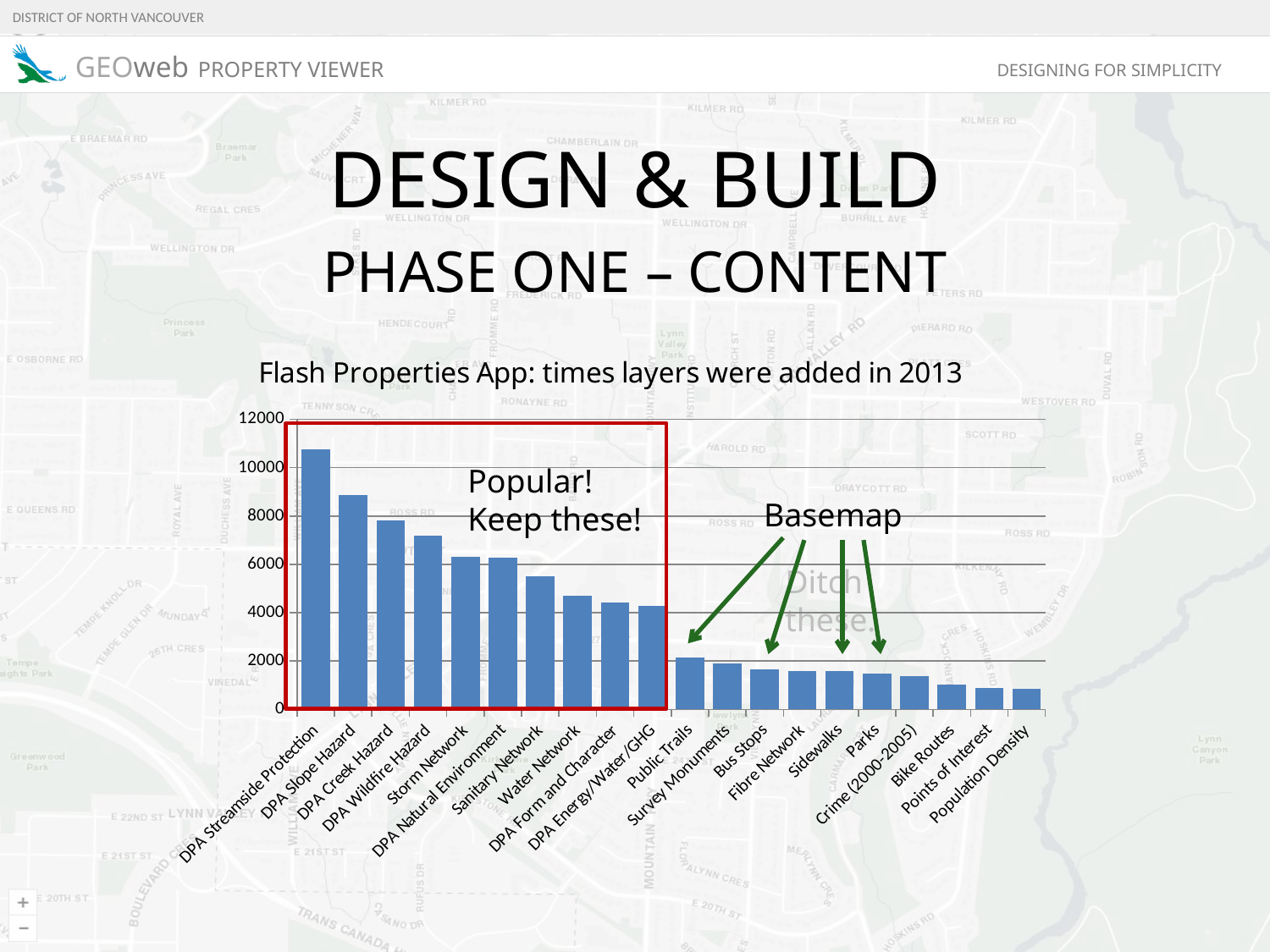
What is the title of the chart? Flash Properties App: times layers were added in 2013 Is the value for DPA Slope Hazard greater or less than 8000? greater What text is written inside the red box drawn over the left group of bars? Popular! Keep these! Which layer has the highest value in the chart? DPA Streamside Protection How many categories (layers) are plotted in the chart? 20 Do the values rise or fall moving from left to right along the x axis? fall Which is larger, the value for DPA Slope Hazard or the value for DPA Creek Hazard? DPA Slope Hazard What kind of chart is shown on the slide? bar chart Is the value for DPA Streamside Protection greater or less than 10000? greater Is the value for Sanitary Network greater or less than 6000? less